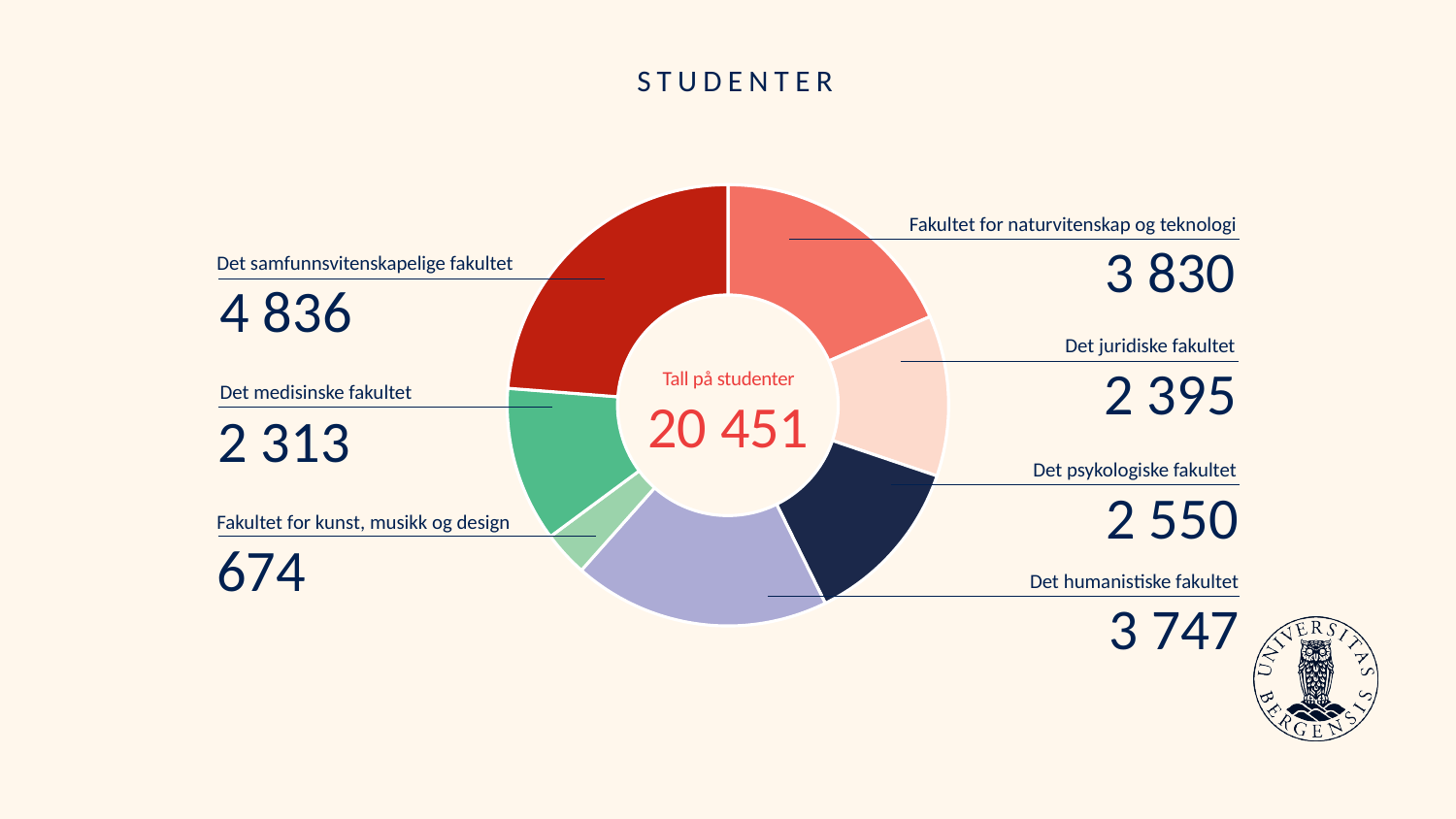
Which has more students, Fakultet for naturvitenskap og teknologi or Det humanistiske fakultet? Fakultet for naturvitenskap og teknologi What is the difference in students between Det samfunnsvitenskapelige fakultet and Fakultet for naturvitenskap og teknologi? 1 006 What is the difference between Det psykologiske fakultet and Det juridiske fakultet? 155 What is the value for Fakultet for kunst, musikk og design? 674 How many students does Det samfunnsvitenskapelige fakultet have? 4 836 How many students are shown for Det humanistiske fakultet? 3 747 What kind of chart is shown on the slide? Pie (donut) chart Which faculty has the lowest number of students? Fakultet for kunst, musikk og design Which faculty has the highest number of students? Det samfunnsvitenskapelige fakultet What is the value shown for Det juridiske fakultet? 2 395 What total number of students is printed in the centre of the chart? 20 451 How many faculties are shown in the chart? 7